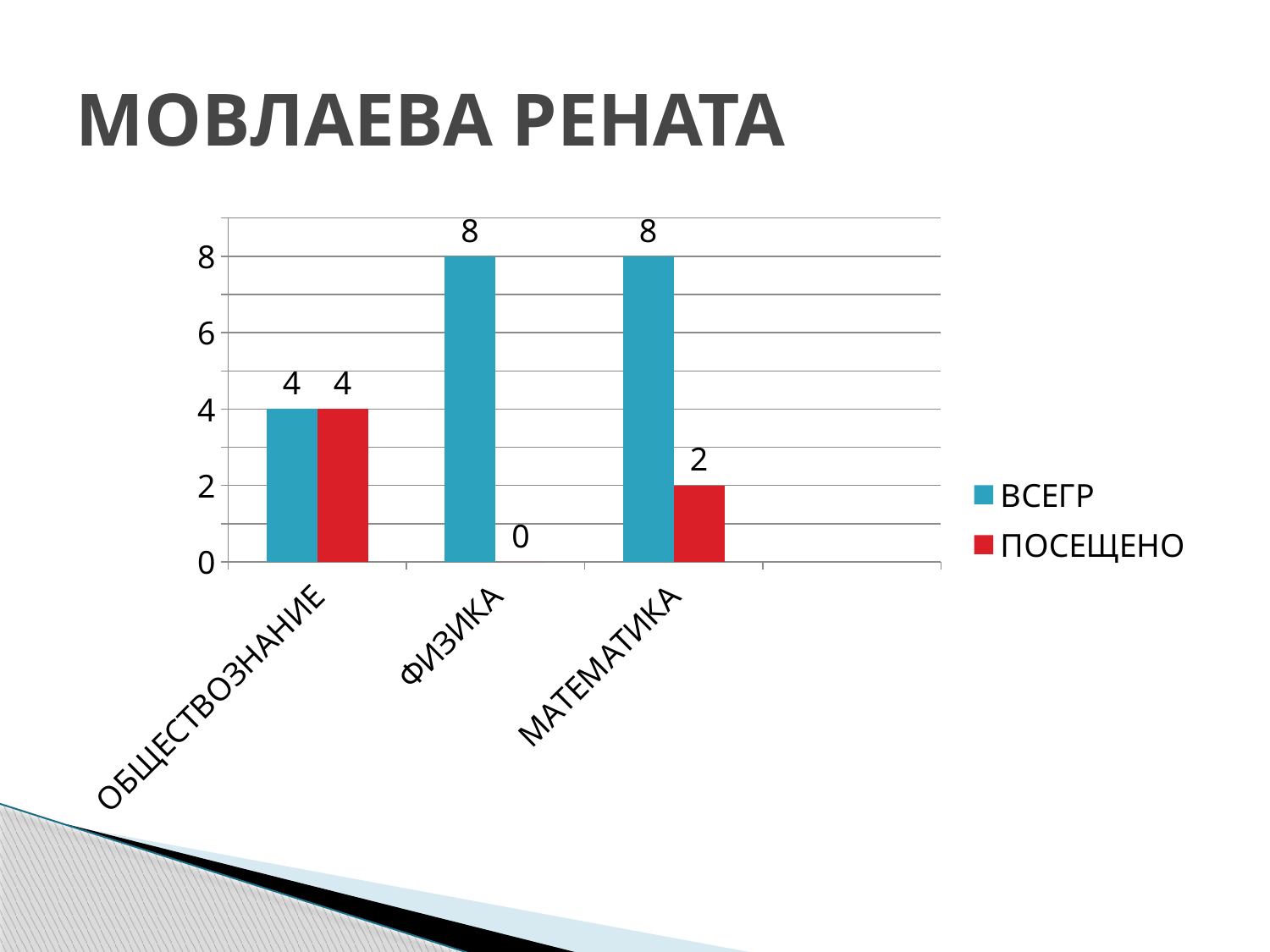
What is the ПОСЕЩЕНО value for МАТЕМАТИКА? 2 What is the ПОСЕЩЕНО value for ОБЩЕСТВОЗНАНИЕ? 4 What kind of chart is shown on the slide? Bar chart Which is larger for ОБЩЕСТВОЗНАНИЕ: the ВСЕГР value or the ПОСЕЩЕНО value? They are equal Which category has the highest ПОСЕЩЕНО value? ОБЩЕСТВОЗНАНИЕ What colour are the ПОСЕЩЕНО bars? Red How many categories are shown on the x axis? 3 What is the ПОСЕЩЕНО value for ФИЗИКА? 0 What is the difference between the ВСЕГР and ПОСЕЩЕНО values for МАТЕМАТИКА? 6 How many series does the legend list? 2 What is the ВСЕГР value for ФИЗИКА? 8 Which category has the lowest ПОСЕЩЕНО value? ФИЗИКА